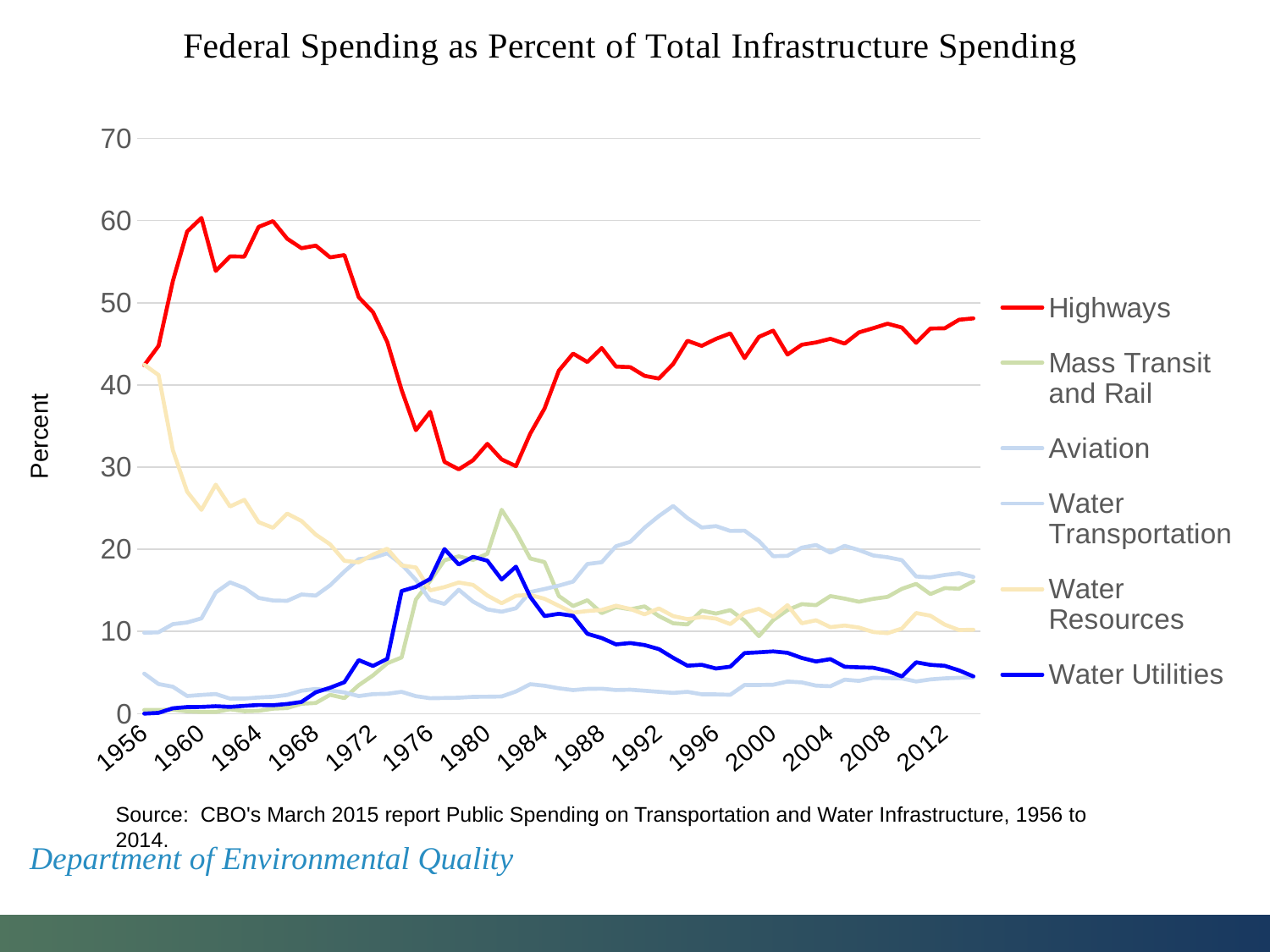
Does the Water Resources line rise or fall between 1956 and 1972? Fall Which series has the highest value in 2012? Highways Is the value for Highways in 1980 greater or less than 40? less Is the value for Water Utilities in 1956 greater or less than 10? less What colour is the Highways line? Red Is the value for Water Resources in 1956 greater or less than 30? greater How many series does the legend list? 6 What kind of chart is shown on the slide? Line chart In 2000, which is larger: the value for Highways or the value for Water Utilities? Highways Which series has the highest value in 1976? Highways What is the title of the chart? Federal Spending as Percent of Total Infrastructure Spending